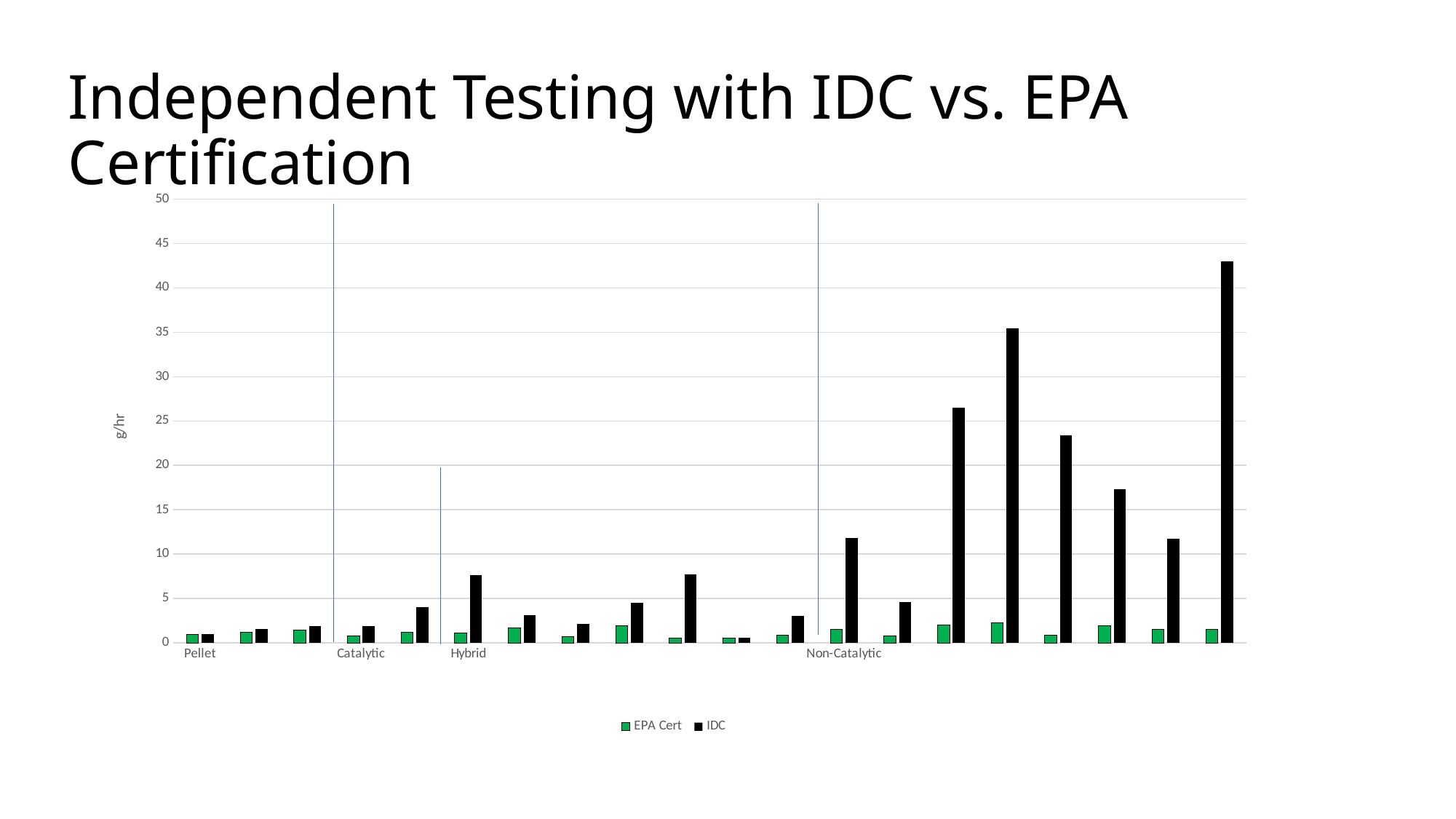
What kind of chart is shown on the slide? bar chart In the Non-Catalytic group, which series generally has the taller bars, EPA Cert or IDC? IDC Which series has the tallest bar on the chart? IDC What is the label on the vertical axis? g/hr How many series does the legend list? 2 How many stove-type group labels appear along the x axis? 4 Is the tallest bar in the Hybrid group greater or less than 10? less Is the tallest bar in the Pellet group greater or less than 5? less Is the tallest EPA Cert bar greater or less than 5? less Which group on the x axis contains the tallest bar? Non-Catalytic What are the two series named in the legend? EPA Cert and IDC